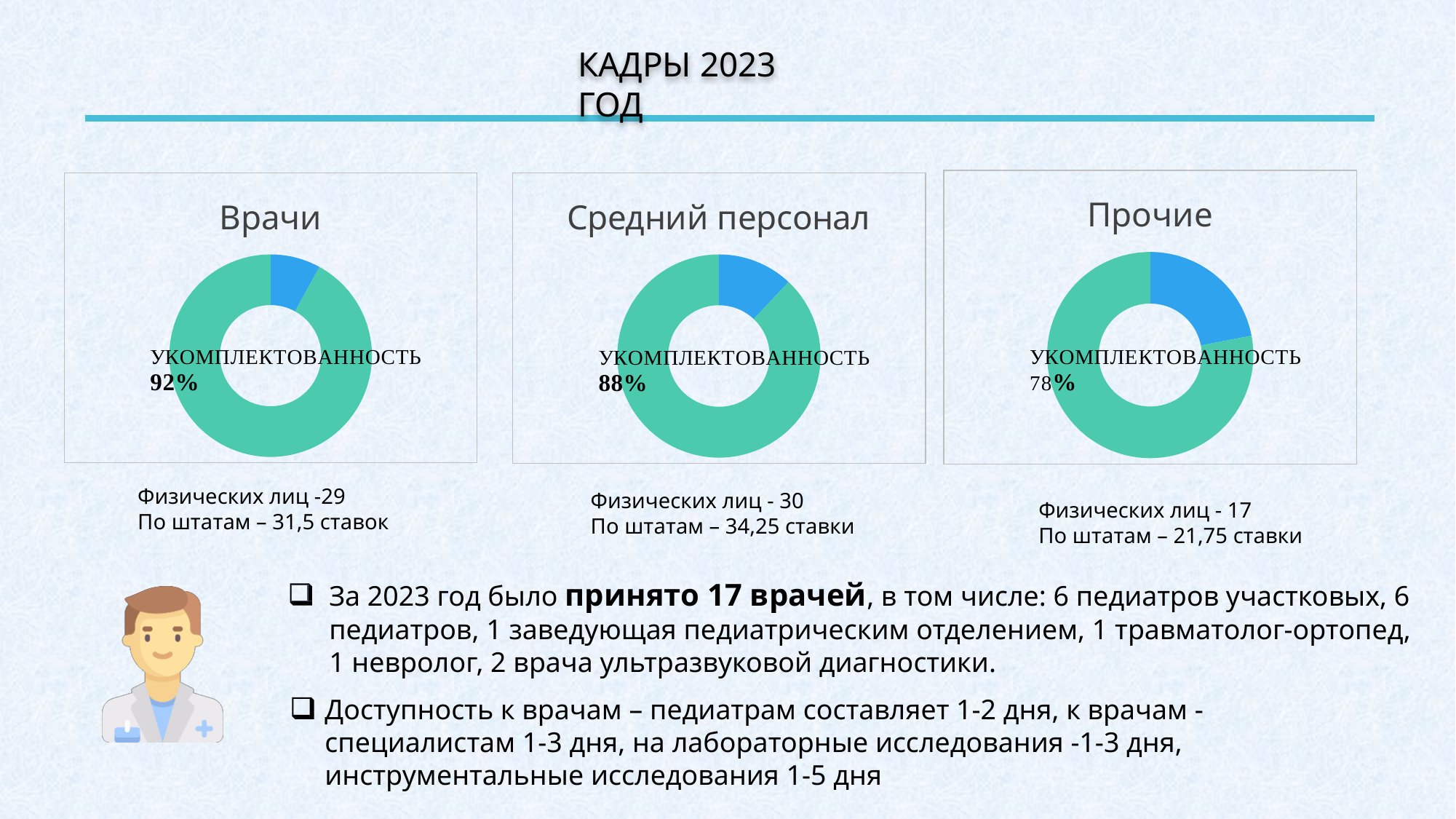
Which of the three charts shows the highest staffing level? Врачи Which of the three charts shows the lowest staffing level? Прочие On the 'Прочие' chart, what staffing level (укомплектованность) is shown? 78% What is the title of the chart on the right of the slide? Прочие On the 'Врачи' chart, what staffing level (укомплектованность) is shown? 92% How many charts are shown on the slide? 3 By how many percentage points does the staffing level on the 'Врачи' chart exceed that on the 'Средний персонал' chart? 4 By how many percentage points does the staffing level on the 'Врачи' chart exceed that on the 'Прочие' chart? 14 On the 'Средний персонал' chart, what staffing level (укомплектованность) is shown? 88% On the 'Прочие' chart, what share of the ring is not covered by the 78% staffed portion? 22% Which chart shows a larger staffing level, 'Средний персонал' or 'Прочие'? Средний персонал What kind of chart is used for 'Врачи', 'Средний персонал' and 'Прочие'? Pie (donut) chart